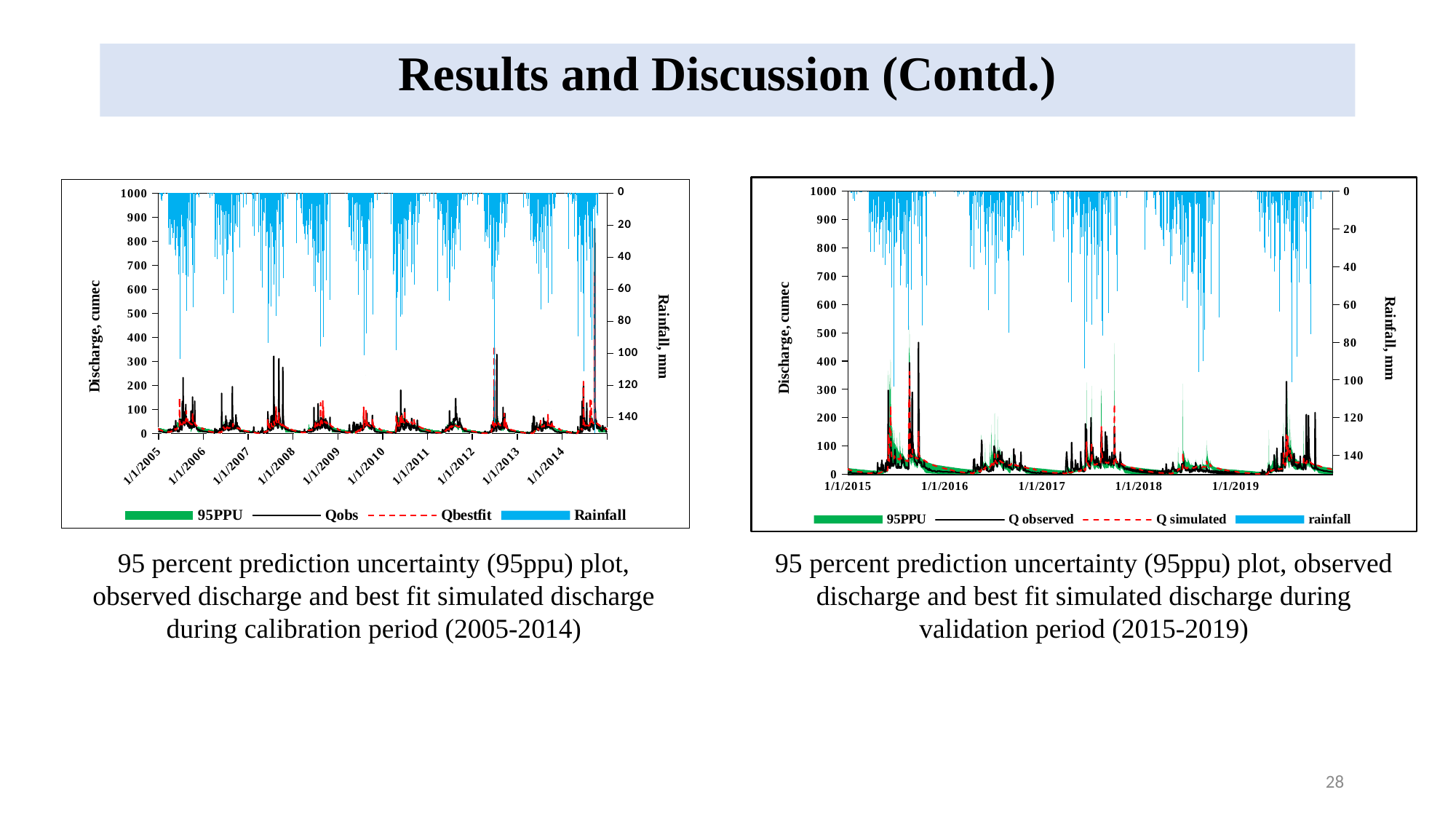
In the right chart (validation period), what is the maximum tick value shown on the Rainfall axis? 140 In the left chart (calibration period), what is the maximum tick value shown on the Discharge axis? 1000 How many series does the legend of the left chart (calibration period 2005-2014) list? 4 In the left chart (calibration period), what is the label of the left vertical axis? Discharge, cumec How many date labels are shown along the x axis of the right chart (validation period)? 5 In the right chart (validation period), is the highest peak of the Q observed line greater or less than 300 cumec? greater In the left chart (calibration period), what are the four legend entries? 95PPU, Qobs, Qbestfit, Rainfall How many date labels are shown along the x axis of the left chart (calibration period)? 10 In the left chart (calibration period), is the highest peak of the Qobs line greater or less than 500 cumec? less In the right chart (validation period), what are the four legend entries? 95PPU, Q observed, Q simulated, rainfall How many series does the legend of the right chart (validation period 2015-2019) list? 4 In the right chart (validation period), what is the label of the right vertical axis? Rainfall, mm